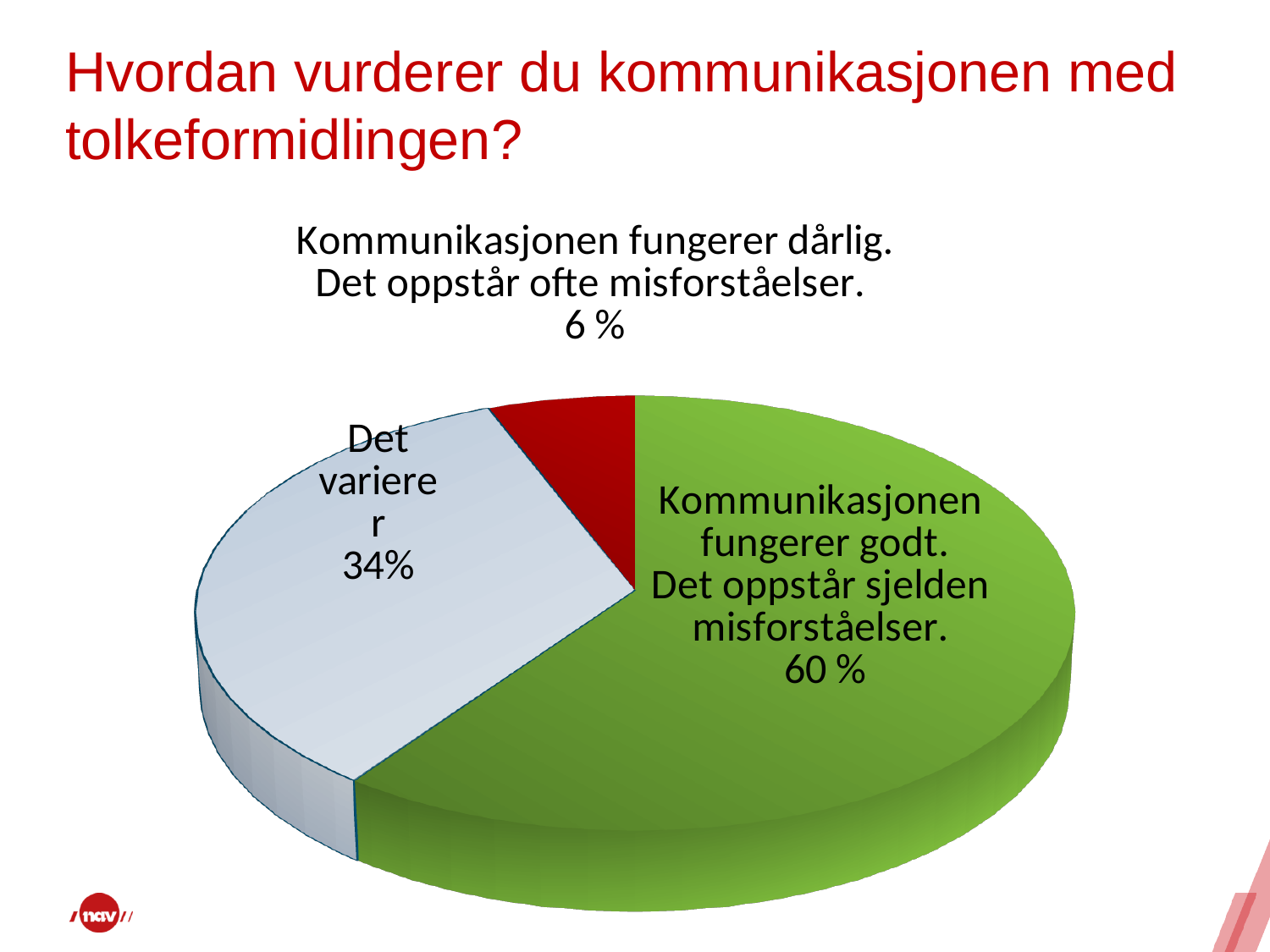
What kind of chart is shown on the slide? Pie chart What is the difference in percentage points between the "Kommunikasjonen fungerer godt" slice and the "Det varierer" slice? 26 Which is larger: the "Det varierer" slice or the "Kommunikasjonen fungerer dårlig" slice? Det varierer What is the difference in percentage points between the "Det varierer" slice and the "Kommunikasjonen fungerer dårlig" slice? 28 What is the title of the slide containing the pie chart? Hvordan vurderer du kommunikasjonen med tolkeformidlingen? What share of the pie is labelled "Det varierer"? 34% Which slice of the pie chart is the smallest? Kommunikasjonen fungerer dårlig. Det oppstår ofte misforståelser. Which slice of the pie chart is the largest? Kommunikasjonen fungerer godt. Det oppstår sjelden misforståelser. What colour is the "Det varierer" slice of the pie chart? Light blue-grey What share of the pie is labelled "Kommunikasjonen fungerer dårlig. Det oppstår ofte misforståelser."? 6 % How many slices does the pie chart have? 3 What share of the pie is labelled "Kommunikasjonen fungerer godt. Det oppstår sjelden misforståelser."? 60 %